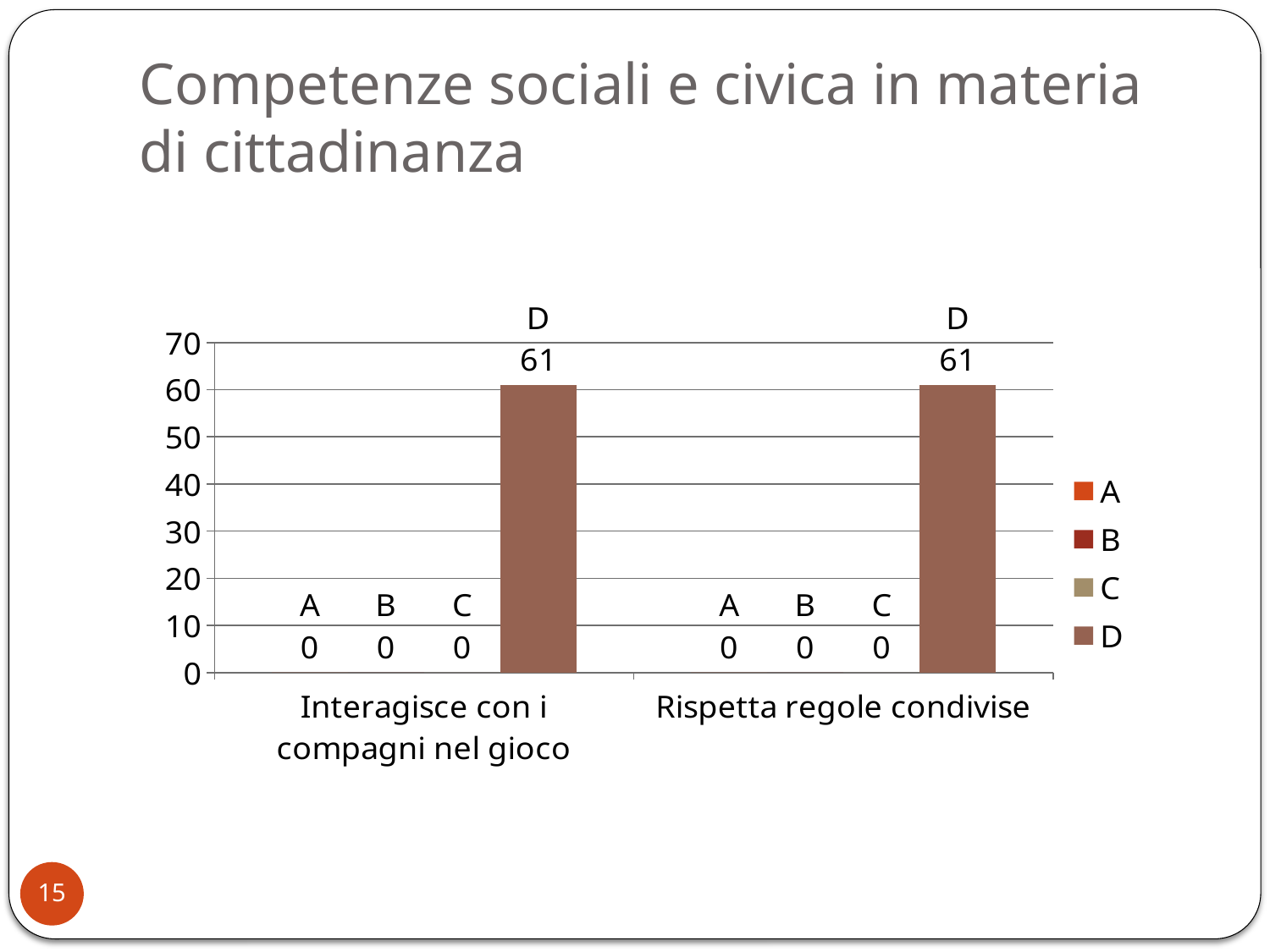
Which series has the highest value for "Interagisce con i compagni nel gioco"? D What is the value of series C for "Interagisce con i compagni nel gioco"? 0 What is the value of series A for "Rispetta regole condivise"? 0 What is the difference between series D and series B for "Rispetta regole condivise"? 61 Is the value of series D for "Rispetta regole condivise" greater or less than 50? greater What kind of chart is shown on the slide? bar chart How many series does the legend list? 4 What is the highest value shown on the y axis? 70 What is the value of series D for "Rispetta regole condivise"? 61 What is the total of all four series for "Interagisce con i compagni nel gioco"? 61 What is the value of series D for "Interagisce con i compagni nel gioco"? 61 How many categories are shown on the x axis? 2